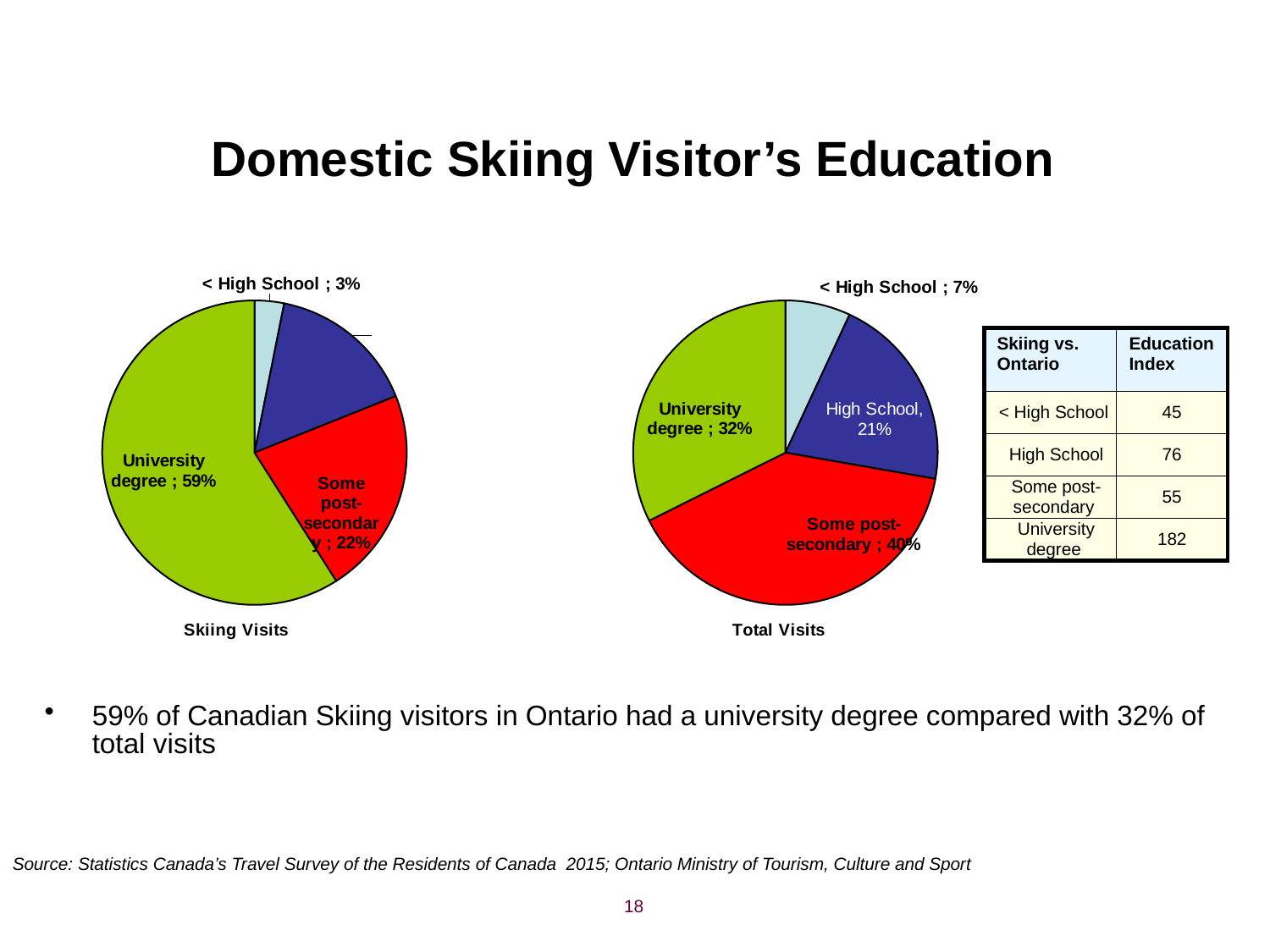
In the Skiing Visits pie chart, what share of visits is for University degree? 59% How many percentage points higher is the University degree share in the Skiing Visits chart than in the Total Visits chart? 27 percentage points In the Total Visits pie chart, what share of visits is for < High School? 7% In the Total Visits pie chart, what share of visits is for Some post-secondary? 40% In the Total Visits pie chart, what share of visits is for University degree? 32% In the Total Visits pie chart, what share of visits is for High School? 21% In the Skiing Visits pie chart, which education category has the largest slice? University degree What type of chart is used for Skiing Visits and Total Visits? Pie chart In the Skiing Visits pie chart, what share of visits is for Some post-secondary? 22% In the Skiing Visits pie chart, what share of visits is for < High School? 3% In the Total Visits pie chart, which education category has the largest slice? Some post-secondary In the Total Visits pie chart, which education category has the smallest slice? < High School